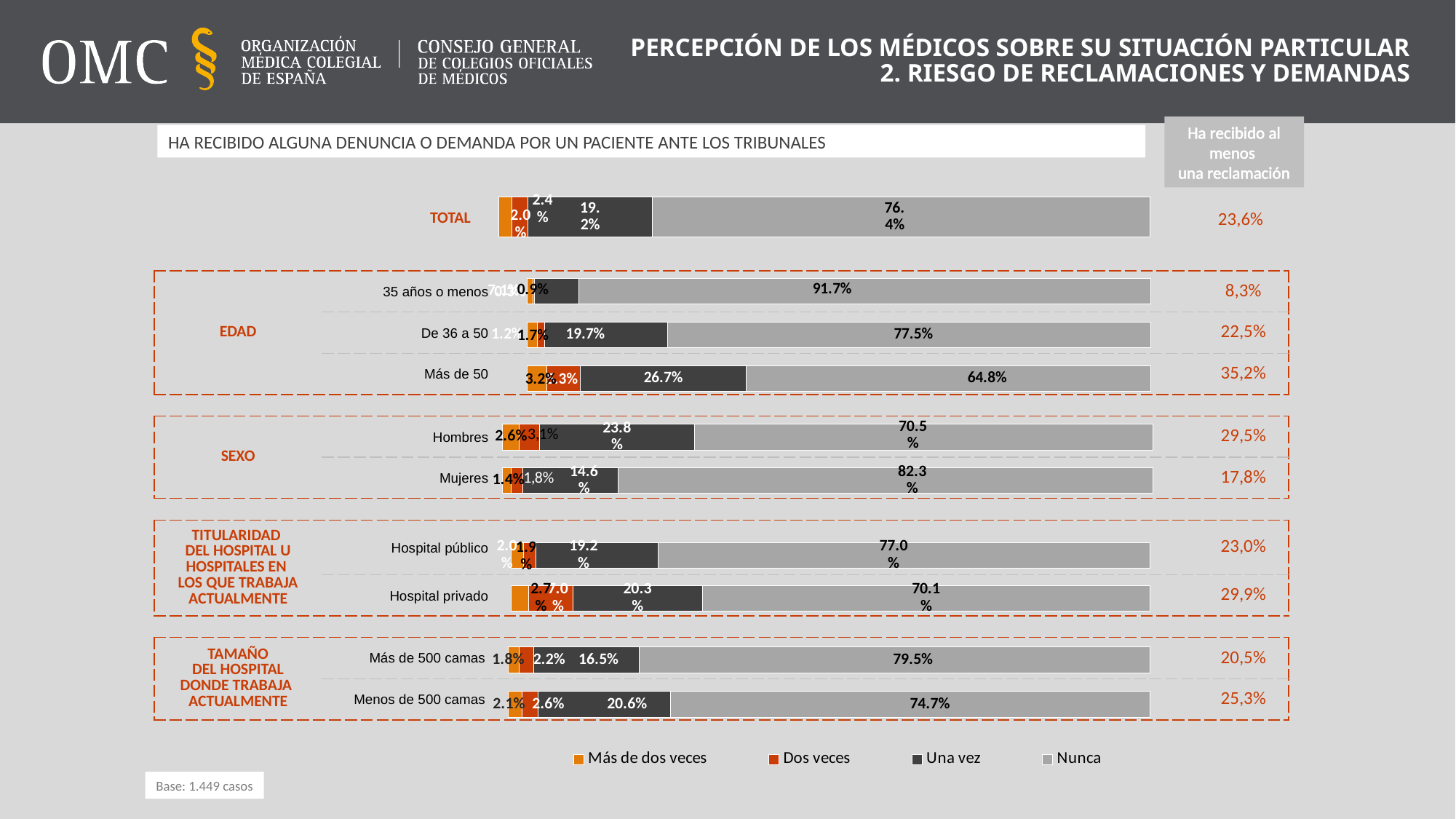
What is the 'Nunca' value for 'Mujeres'? 82.3% Which category has the highest 'Nunca' value? 35 años o menos What is the 'Una vez' value for 'Más de 50'? 26.7% What kind of chart is shown on the slide? stacked bar chart What is the last entry in the legend? Nunca What is the 'Nunca' value for '35 años o menos'? 91.7% What is the 'Ha recibido al menos una reclamación' value for 'Más de 50'? 35,2% Which category has the lowest 'Nunca' value? Más de 50 What is the difference between the 'Nunca' values for 'Hombres' and 'Mujeres'? 11.8% How many series does the legend list? 4 What is the 'Una vez' value for 'Más de 500 camas'? 16.5% Which has a larger 'Una vez' value, 'Hospital público' or 'Hospital privado'? Hospital privado